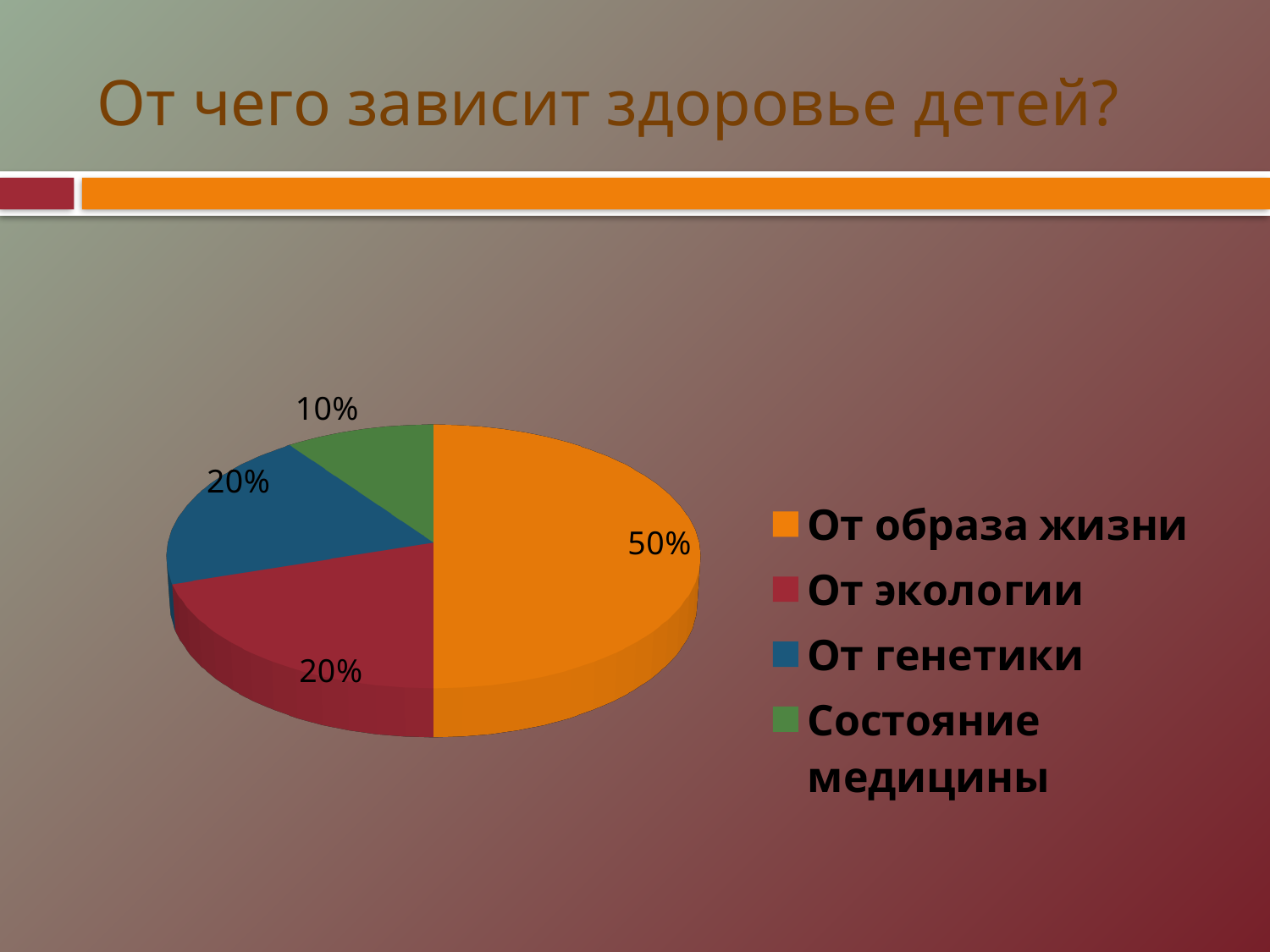
What kind of chart is shown on the slide? pie chart Which is larger, the slice for "От экологии" or the slice for "Состояние медицины"? От экологии What share of the pie does "От генетики" have? 20% What is the difference between the shares of "От образа жизни" and "Состояние медицины"? 40% What share of the pie does "От экологии" have? 20% What share of the pie does "Состояние медицины" have? 10% What colour is the slice for "От генетики"? blue Which category has the smallest slice of the pie? Состояние медицины What is the title of the slide containing the chart? От чего зависит здоровье детей? How many categories does the pie chart have? 4 Which category has the largest slice of the pie? От образа жизни